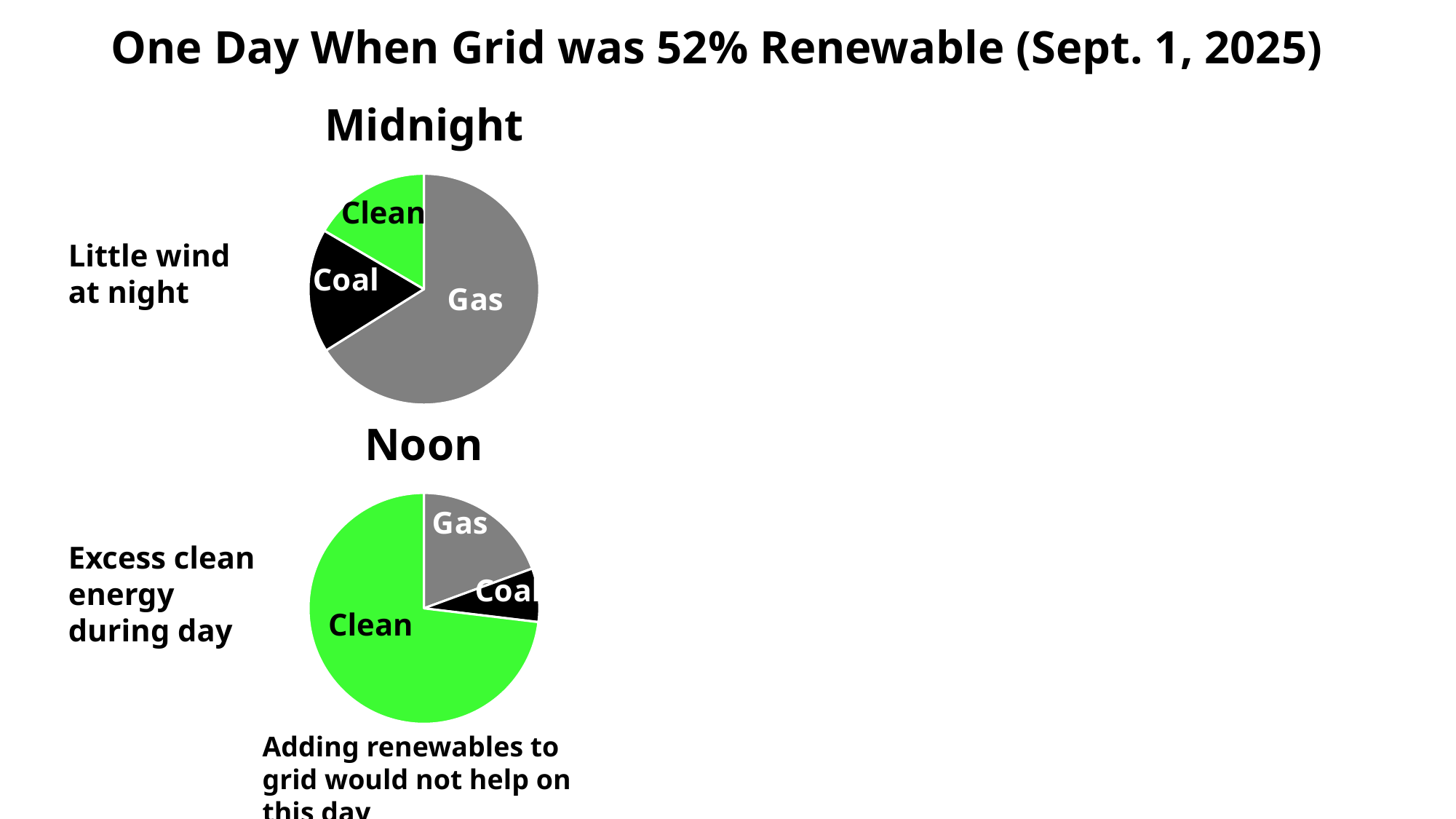
What is the title of the slide containing the two pie charts? One Day When Grid was 52% Renewable (Sept. 1, 2025) In the Midnight chart, which is larger, the Clean slice or the Gas slice? Gas In the Noon chart, which slice is the smallest? Coal In the Noon chart, which slice is the largest? Clean What colour is the Clean slice in the Noon chart? Green What kind of chart is the Noon chart? Pie chart What kind of chart is the Midnight chart? Pie chart In the Noon chart, which is larger, the Gas slice or the Coal slice? Gas How many slices does the Noon pie chart have? 3 In the Midnight chart, which slice is the largest? Gas How many slices does the Midnight pie chart have? 3